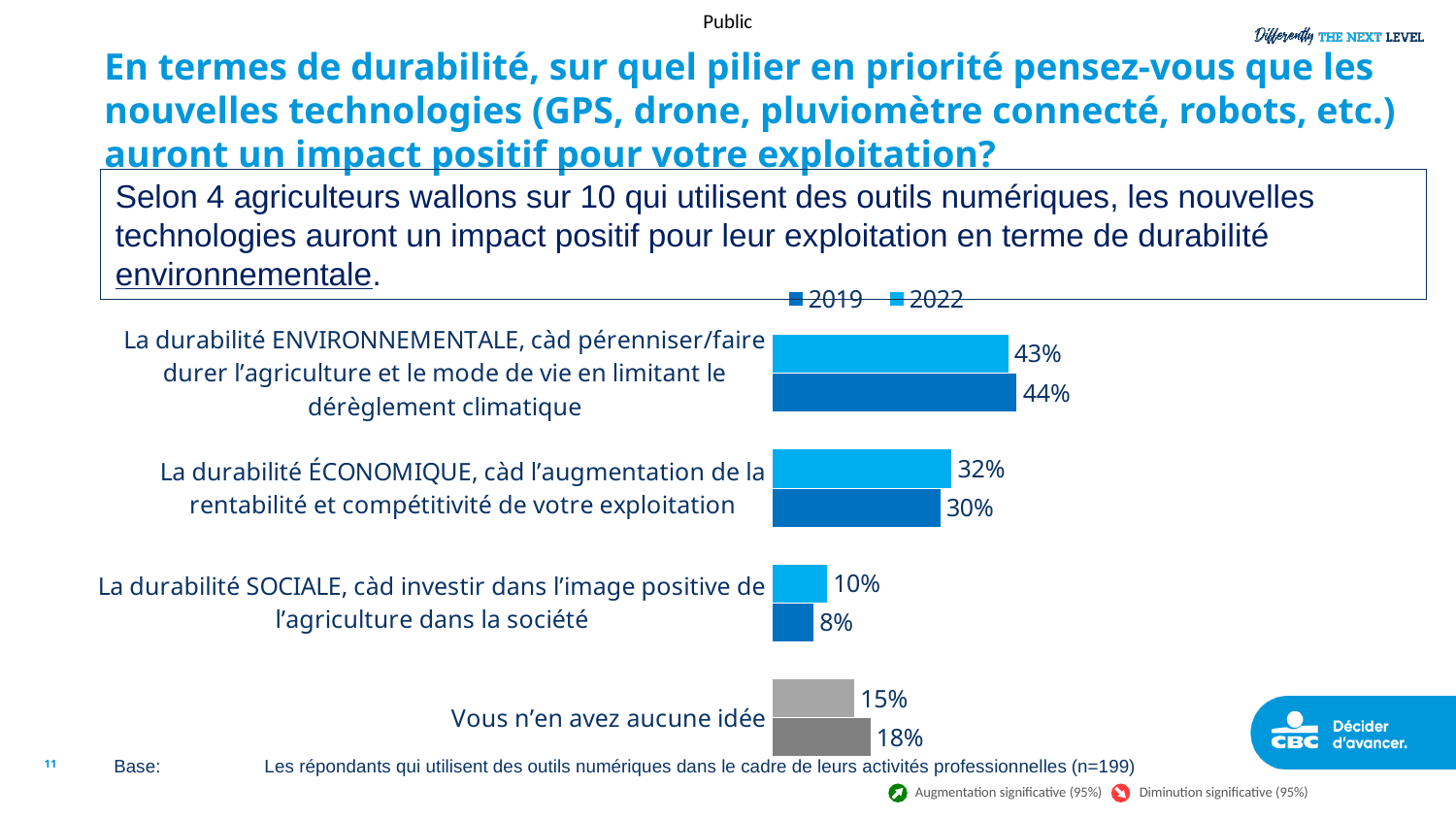
What is the value of the lower (darker blue) bar for 'La durabilité ENVIRONNEMENTALE'? 44% What are the two series named in the chart legend? 2019 and 2022 Which category has the lowest value among the upper (lighter) bars? La durabilité SOCIALE How many categories (answer options) are plotted in the chart? 4 What kind of chart is shown on the slide? Bar chart What is the value of the upper (lighter blue) bar for 'La durabilité ÉCONOMIQUE'? 32% How many series does the chart legend list? 2 Which category has the highest value among the lower (darker) bars? La durabilité ENVIRONNEMENTALE What is the value of the lower (darker blue) bar for 'La durabilité SOCIALE'? 8% What is the value of the lower (darker grey) bar for 'Vous n'en avez aucune idée'? 18% What is the value of the upper (lighter blue) bar for 'La durabilité ENVIRONNEMENTALE'? 43% For 'La durabilité ÉCONOMIQUE', what is the difference between the upper bar (32%) and the lower bar (30%)? 2 percentage points